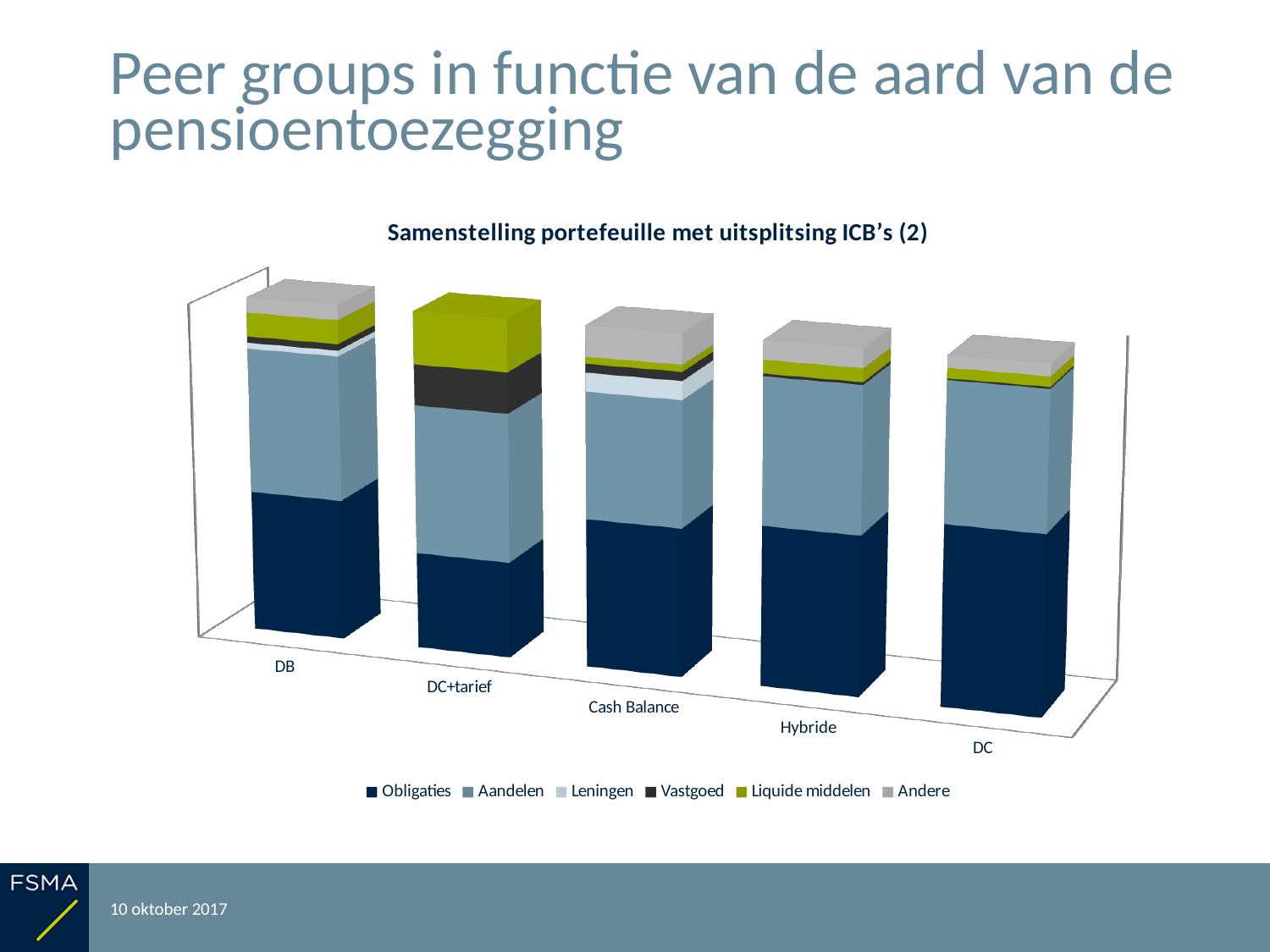
Which category has the largest Liquide middelen segment? DC+tarief Which category has the largest Vastgoed segment? DC+tarief How many series does the legend of the chart list? 6 What kind of chart is shown on the slide? Stacked bar chart What is the title of the chart? Samenstelling portefeuille met uitsplitsing ICB’s (2) Which category is shown furthest to the right on the x axis? DC Which category has the largest Leningen segment? Cash Balance How many categories are shown on the x axis of the chart? 5 Which series is listed first in the chart legend? Obligaties Is the Vastgoed segment larger for DC+tarief or for Hybride? DC+tarief Is the Liquide middelen segment larger for DC+tarief or for DC? DC+tarief Is the Leningen segment larger for Cash Balance or for DB? Cash Balance